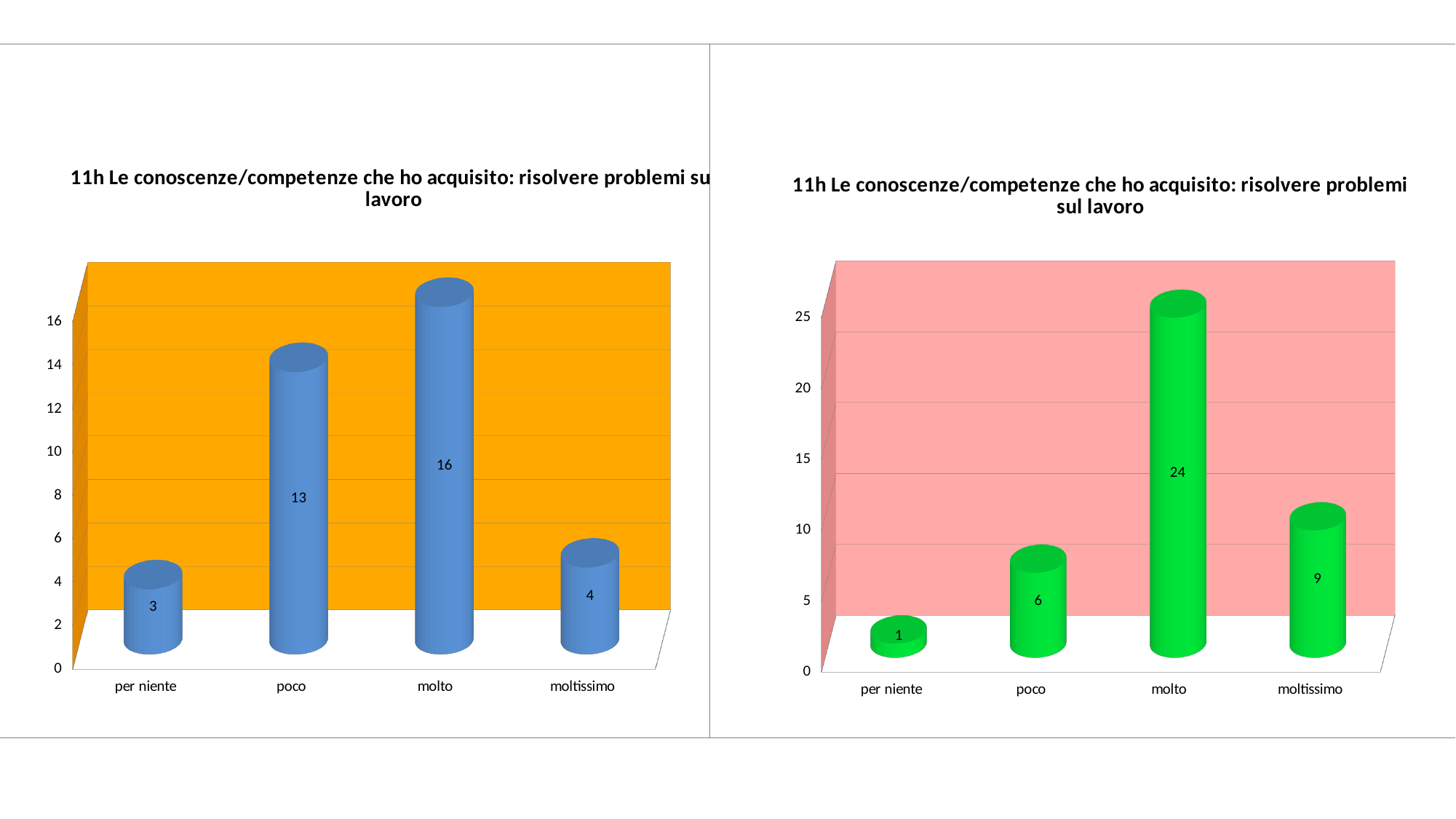
How many categories are shown on the x axis of the right chart? 4 In the left chart, which is larger, the value for "poco" or the value for "moltissimo"? poco In the right chart, what is the difference between the values for "molto" and "moltissimo"? 15 In the right chart, is the value for "molto" greater or less than 20? greater In the left chart, which category has the lowest value? per niente What kind of chart is the left chart? bar chart In the right chart, which category has the highest value? molto In the right chart, what is the total of all four values? 40 In the left chart, what is the value for "molto"? 16 In the left chart, what is the difference between the values for "poco" and "moltissimo"? 9 What colour are the bars in the right chart? green In the right chart, what is the value for "poco"? 6